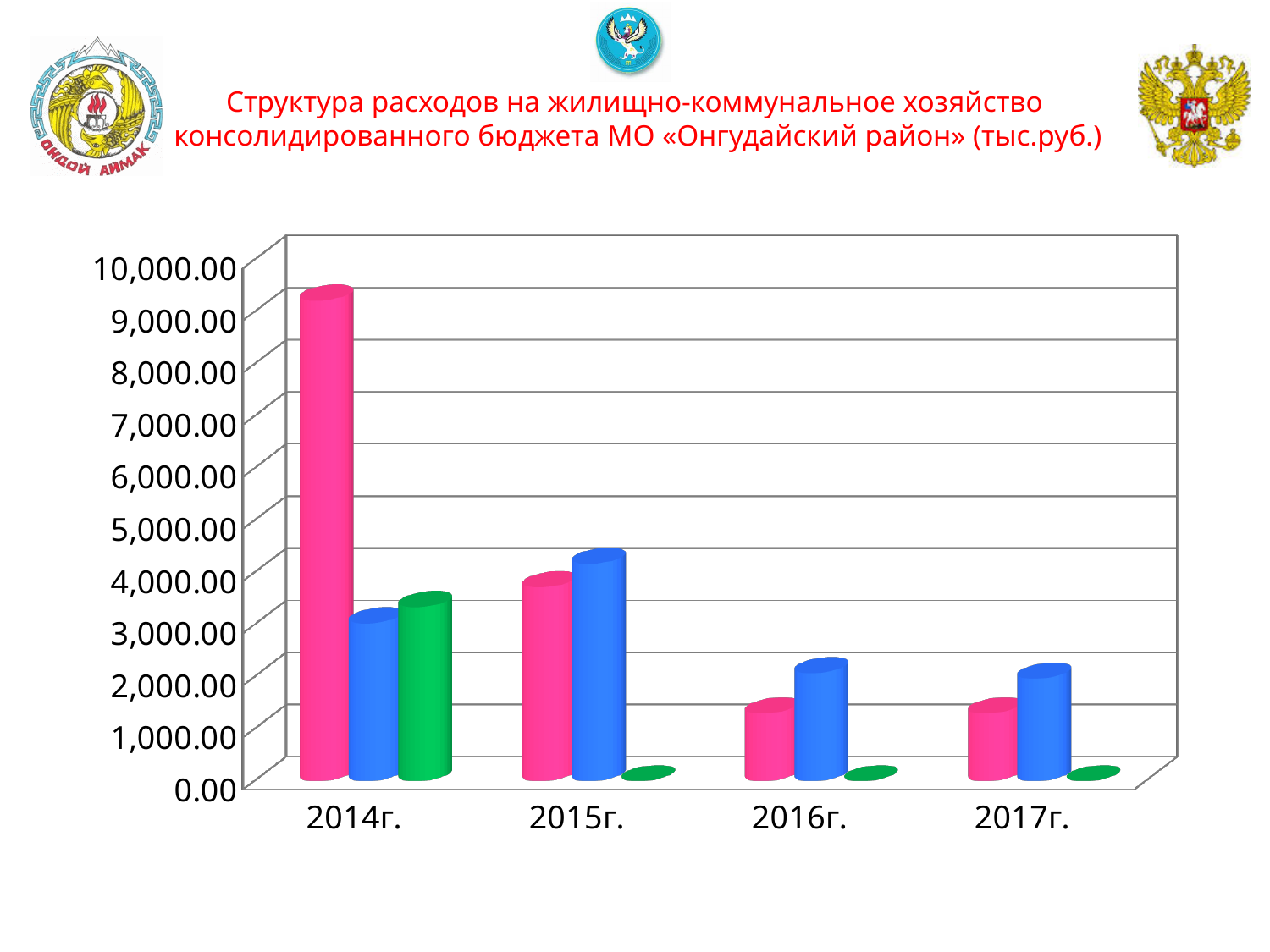
How many year categories are shown on the x axis? 4 Is the blue bar for 2015г. greater or less than 3,000.00? greater What kind of chart is shown on the slide? bar chart What unit is given in the chart title? тыс.руб. Do the pink bars rise or fall from 2014г. to 2017г.? fall Which year has the tallest pink bar? 2014г. In 2014г., which is larger, the pink bar or the blue bar? the pink bar Is the blue bar for 2017г. greater or less than 3,000.00? less Is the pink bar for 2014г. greater or less than 8,000.00? greater In 2016г., which is larger, the pink bar or the blue bar? the blue bar Which year has the tallest blue bar? 2015г.